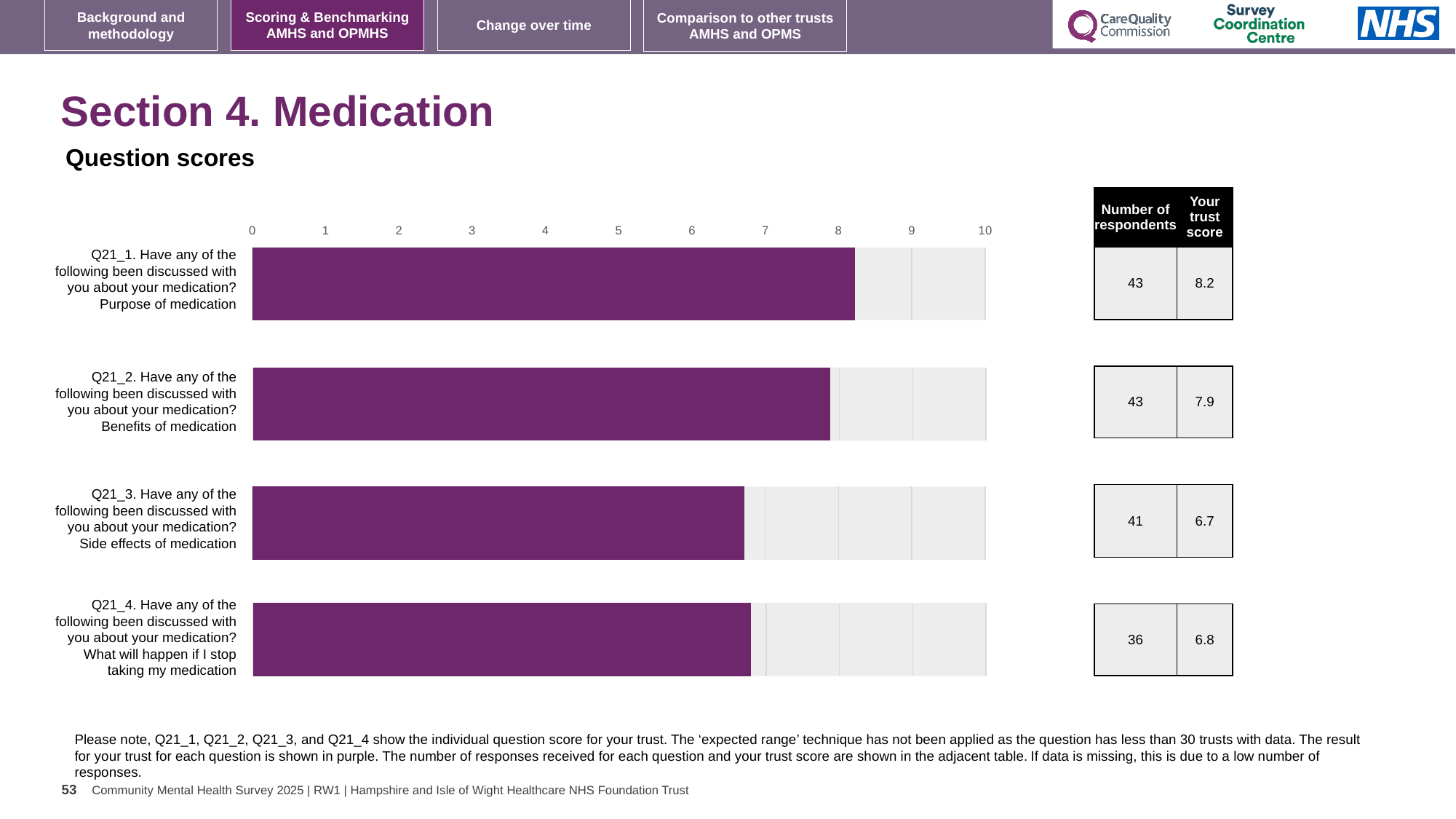
Which has a higher trust score, Q21_2 or Q21_3? Q21_2 What is the trust score for Q21_1 (Purpose of medication)? 8.2 Which question has the lowest trust score? Q21_3 (Side effects of medication) How many questions are plotted in the chart? 4 Is the trust score for Q21_3 greater or less than 7? less What is the trust score for Q21_3 (Side effects of medication)? 6.7 What is the trust score for Q21_4 (What will happen if I stop taking my medication)? 6.8 How many respondents answered Q21_4? 36 What is the difference between the trust scores for Q21_1 and Q21_2? 0.3 What type of chart is shown on the slide? Bar chart Which question has the highest trust score? Q21_1 (Purpose of medication) What is the trust score for Q21_2 (Benefits of medication)? 7.9